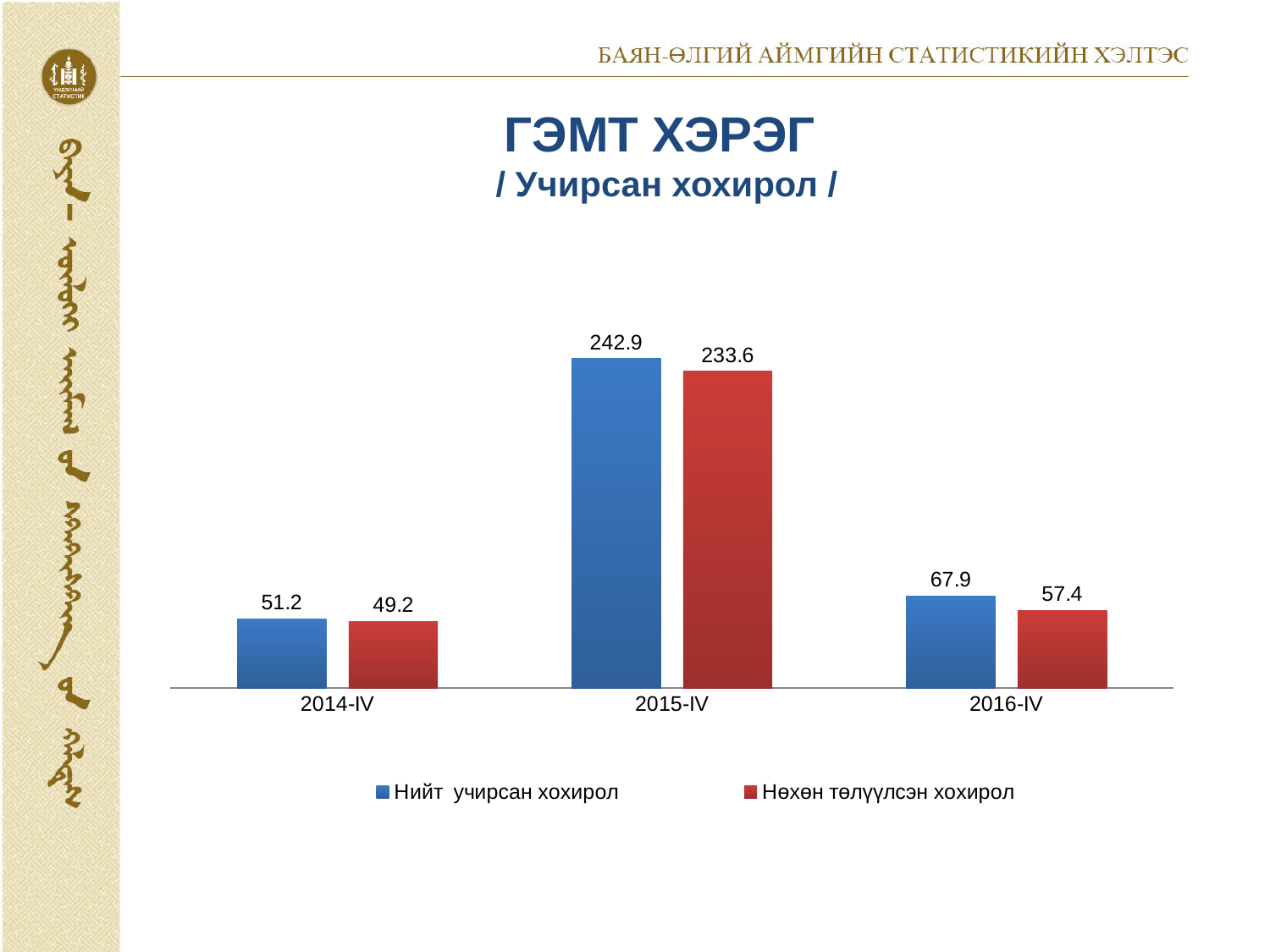
Which is larger in 2016-IV: "Нийт учирсан хохирол" or "Нөхөн төлүүлсэн хохирол"? Нийт учирсан хохирол What is the value of "Нийт учирсан хохирол" for 2016-IV? 67.9 What is the difference between "Нийт учирсан хохирол" and "Нөхөн төлүүлсэн хохирол" in 2015-IV? 9.3 What kind of chart is shown on the slide? Bar chart Which period has the lowest value for "Нөхөн төлүүлсэн хохирол"? 2014-IV What is the value of "Нөхөн төлүүлсэн хохирол" for 2014-IV? 49.2 What is the difference between "Нийт учирсан хохирол" in 2016-IV and in 2014-IV? 16.7 How many series does the legend list? 2 Which period has the highest value for "Нийт учирсан хохирол"? 2015-IV What is the value of "Нийт учирсан хохирол" for 2015-IV? 242.9 What is the value of "Нөхөн төлүүлсэн хохирол" for 2016-IV? 57.4 How many periods are shown on the x axis? 3